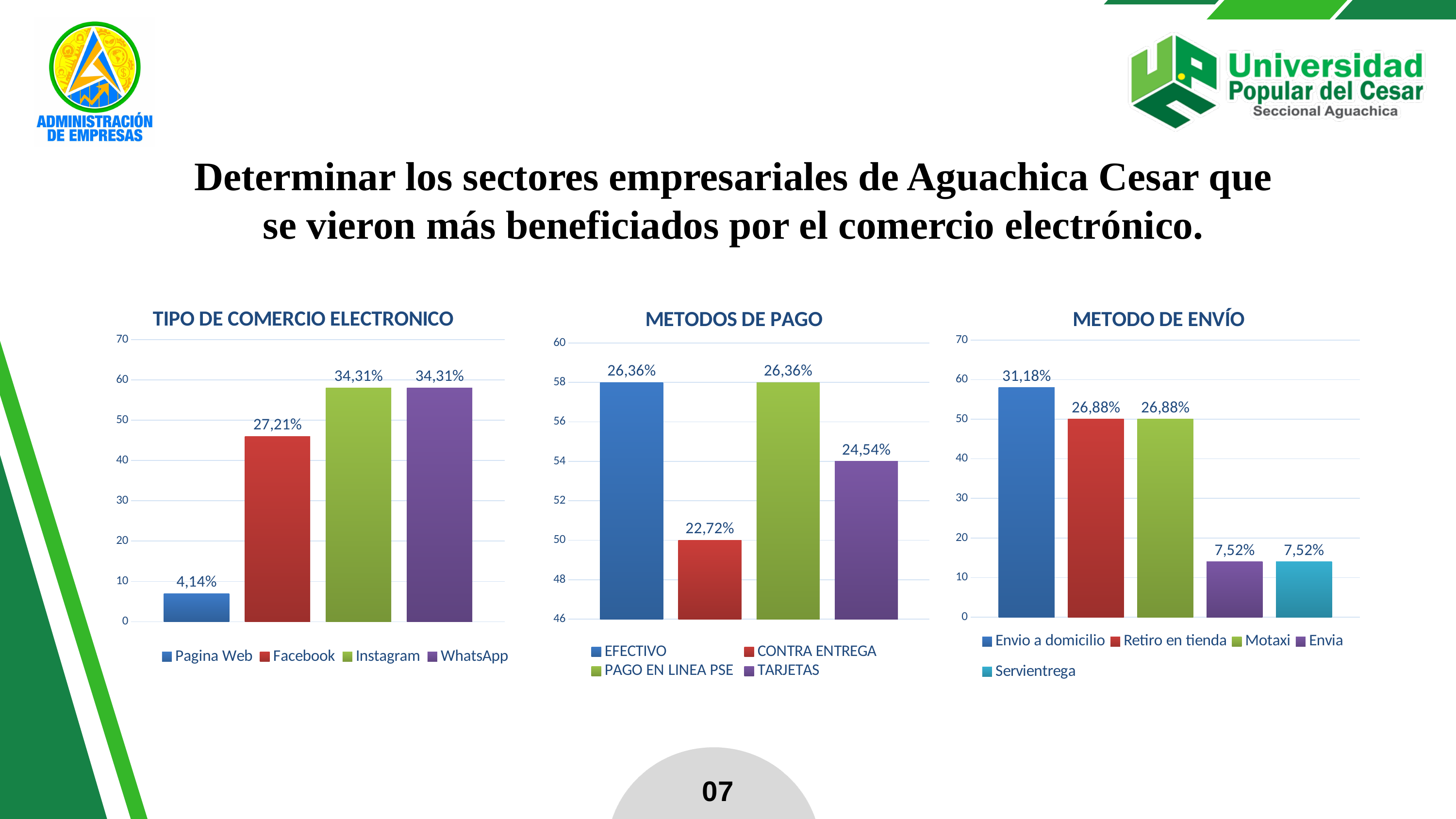
In the METODO DE ENVÍO chart, what is the value labelled for Envio a domicilio? 31,18% In the TIPO DE COMERCIO ELECTRONICO chart, which category has the lowest value? Pagina Web In the METODOS DE PAGO chart, what is the value labelled for TARJETAS? 24,54% In the TIPO DE COMERCIO ELECTRONICO chart, what is the value labelled for Facebook? 27,21% In the METODOS DE PAGO chart, which is larger, EFECTIVO or TARJETAS? EFECTIVO In the TIPO DE COMERCIO ELECTRONICO chart, what is the difference between the labelled values for Facebook and Pagina Web? 23,07% In the METODO DE ENVÍO chart, what is the difference between the labelled values for Retiro en tienda and Envia? 19,36% In the METODOS DE PAGO chart, which category has the lowest value? CONTRA ENTREGA In the METODO DE ENVÍO chart, how many entries does the legend list? 5 What kind of chart is the METODOS DE PAGO chart? Bar chart In the TIPO DE COMERCIO ELECTRONICO chart, how many categories are plotted? 4 In the METODO DE ENVÍO chart, which category has the highest value? Envio a domicilio